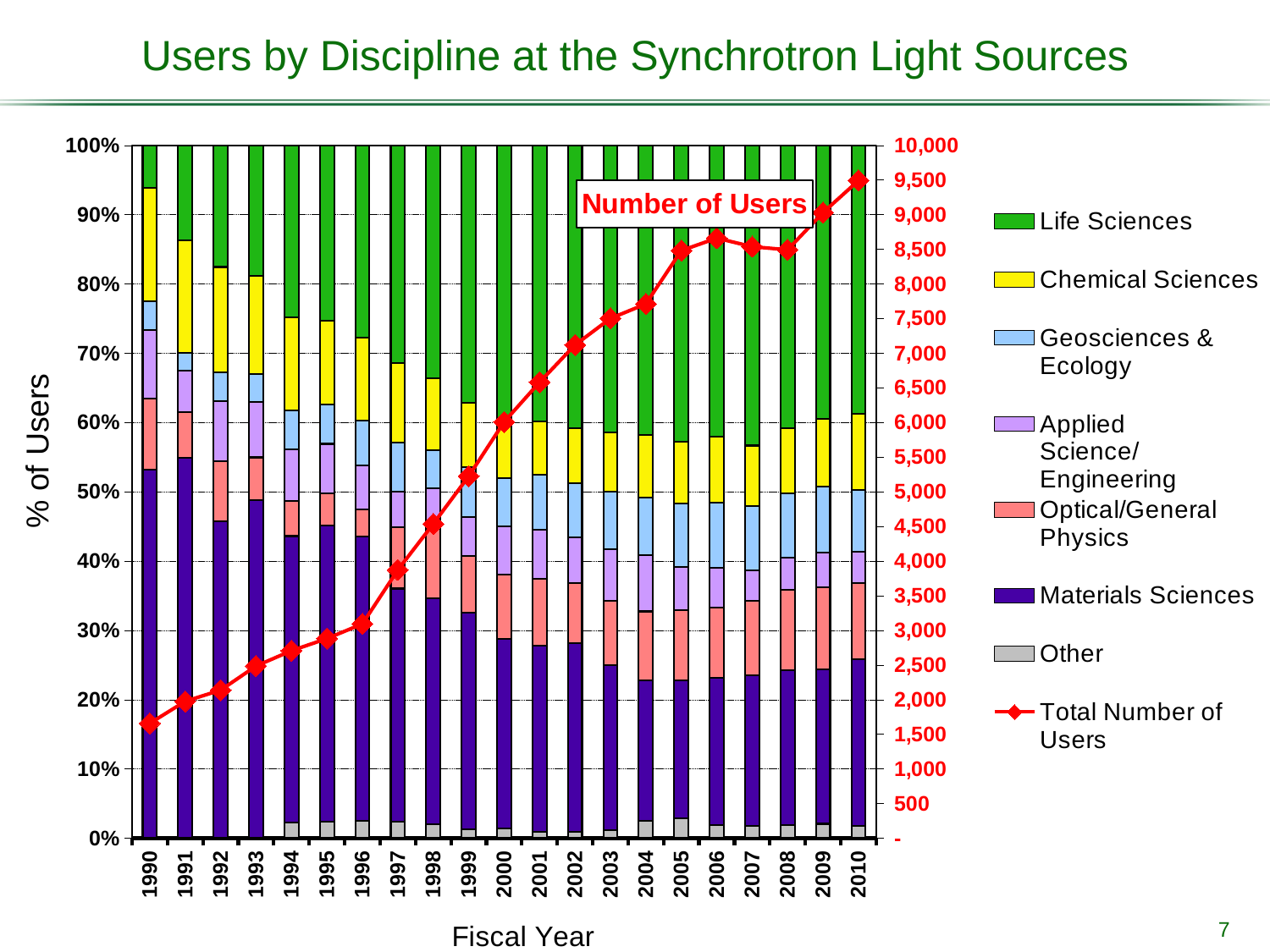
Is the Total Number of Users in 1990 greater or less than 2,000? less What colour represents Life Sciences in the legend? Green In which fiscal year is the Total Number of Users highest? 2010 Is the Total Number of Users in 2008 greater or less than 8,000? greater Which year has the larger Life Sciences share of users, 1990 or 2010? 2010 Is the Materials Sciences share of users in 1991 greater or less than 50%? greater How many fiscal years are shown along the x axis? 21 How many series does the legend list? 8 In which fiscal year is the Total Number of Users lowest? 1990 What kind of chart is shown on the slide? Stacked bar chart with a line overlay Does the Total Number of Users line rise or fall from 1990 to 2010? Rise